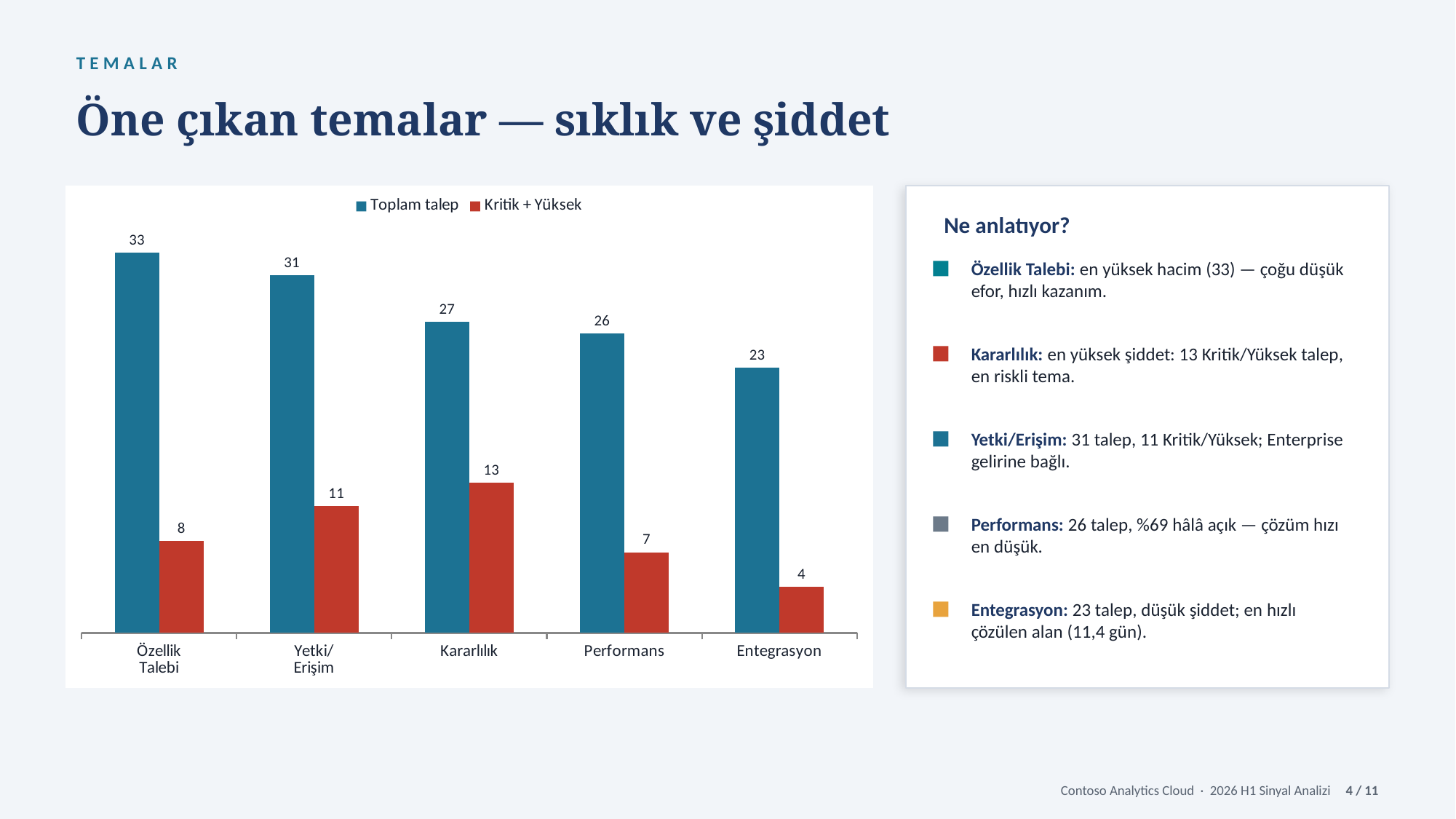
Which category has the lowest Toplam talep value? Entegrasyon What is the Toplam talep value for Özellik Talebi? 33 Do the Toplam talep values rise or fall from left to right along the x axis? Fall What is the difference between the Toplam talep and Kritik + Yüksek values for Yetki/Erişim? 20 Which is larger: the Kritik + Yüksek value for Performans or for Özellik Talebi? Özellik Talebi What kind of chart is shown on the slide? Bar chart Which category has the highest Kritik + Yüksek value? Kararlılık What colour are the Kritik + Yüksek bars? Red What is the Toplam talep value for Entegrasyon? 23 How many categories are shown on the x axis? 5 How many series does the legend list? 2 What is the Kritik + Yüksek value for Kararlılık? 13